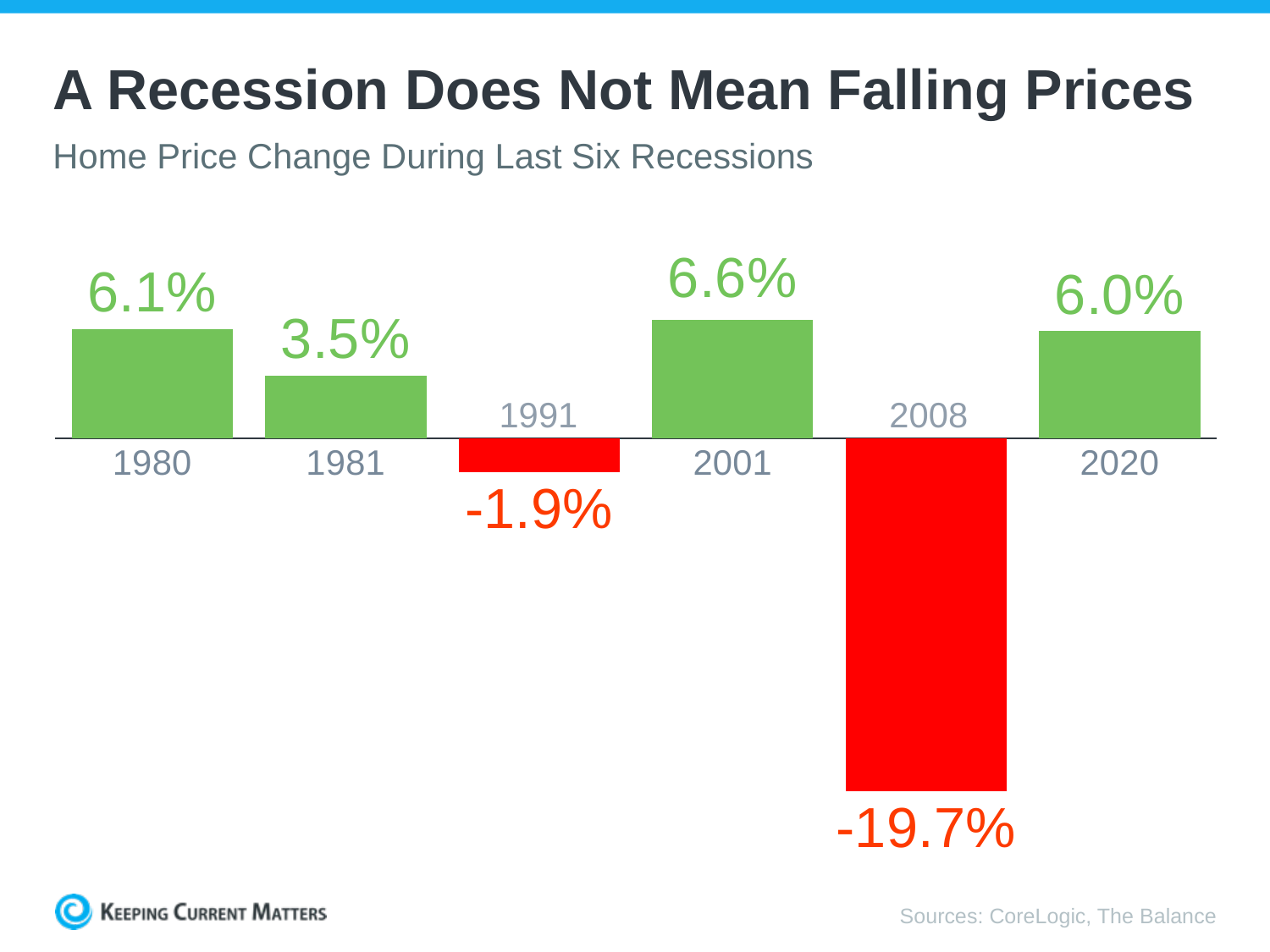
What is the difference between the home price change in 2001 and in 1981? 3.1% What was the home price change during the 1991 recession? -1.9% How many of the recessions shown had a negative home price change? 2 How many recessions are shown in the chart? 6 What was the home price change during the 2008 recession? -19.7% Which recession shows the lowest home price change? 2008 What was the home price change during the 1980 recession? 6.1% Which recession shows the highest home price change? 2001 What kind of chart is shown on the slide? Bar chart Which recession had a larger home price change, 1980 or 1981? 1980 What colour are the bars for recessions with negative home price changes? Red What was the home price change during the 2020 recession? 6.0%